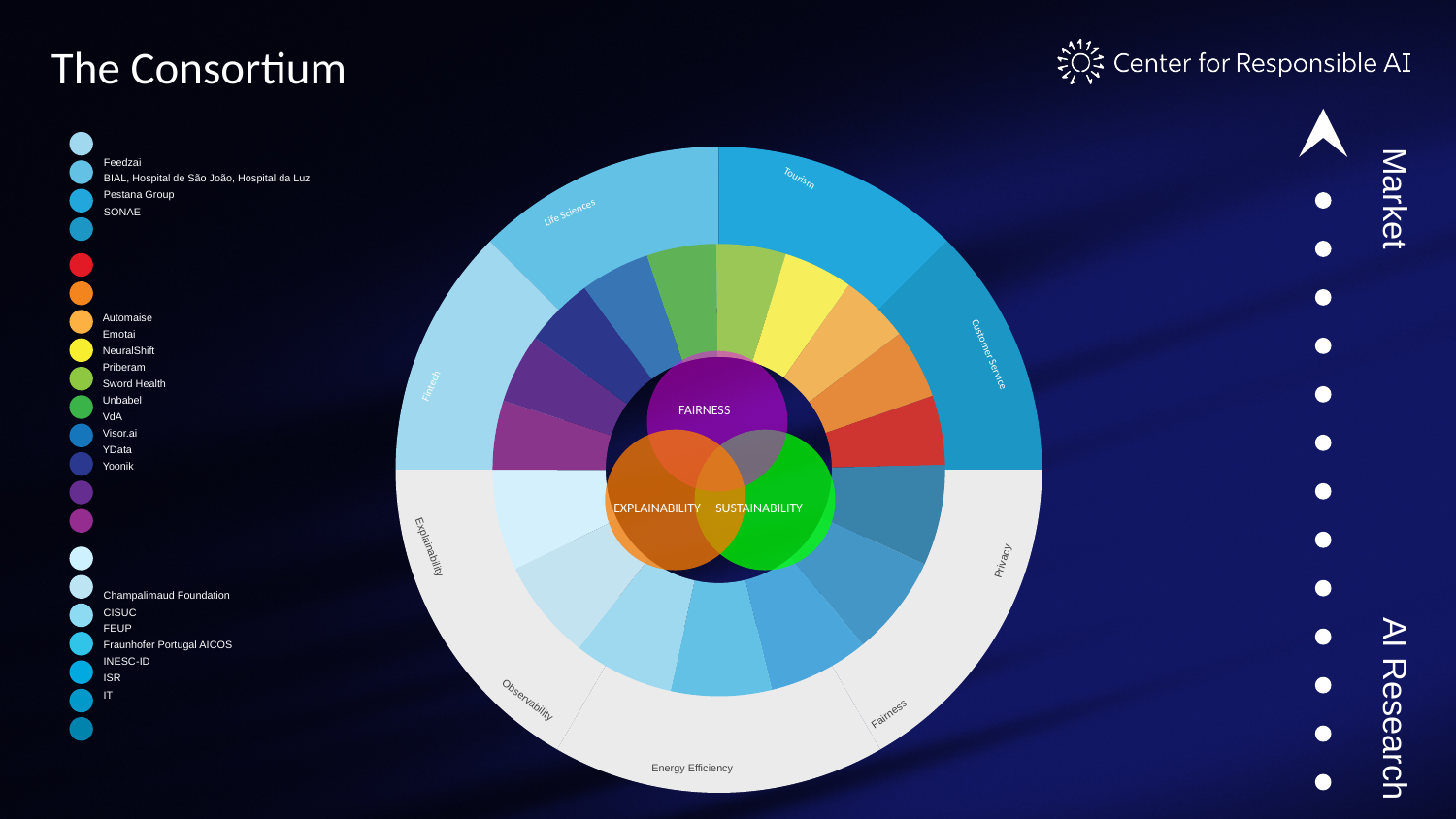
Which outer-ring segment sits between Tourism and Privacy on the right side of the diagram? Customer Service What are the three labels on the overlapping circles at the centre of the diagram? Fairness, Explainability, Sustainability How many labelled segments are in the outer ring of the circular diagram? 9 What kind of chart is the circular diagram on the slide? Doughnut (ring) chart Which outer-ring segment sits between Life Sciences and Explainability on the left side of the diagram? Fintech How many overlapping circles are at the centre of the circular diagram? 3 Which label appears at the bottom of the outer ring of the circular diagram? Energy Efficiency